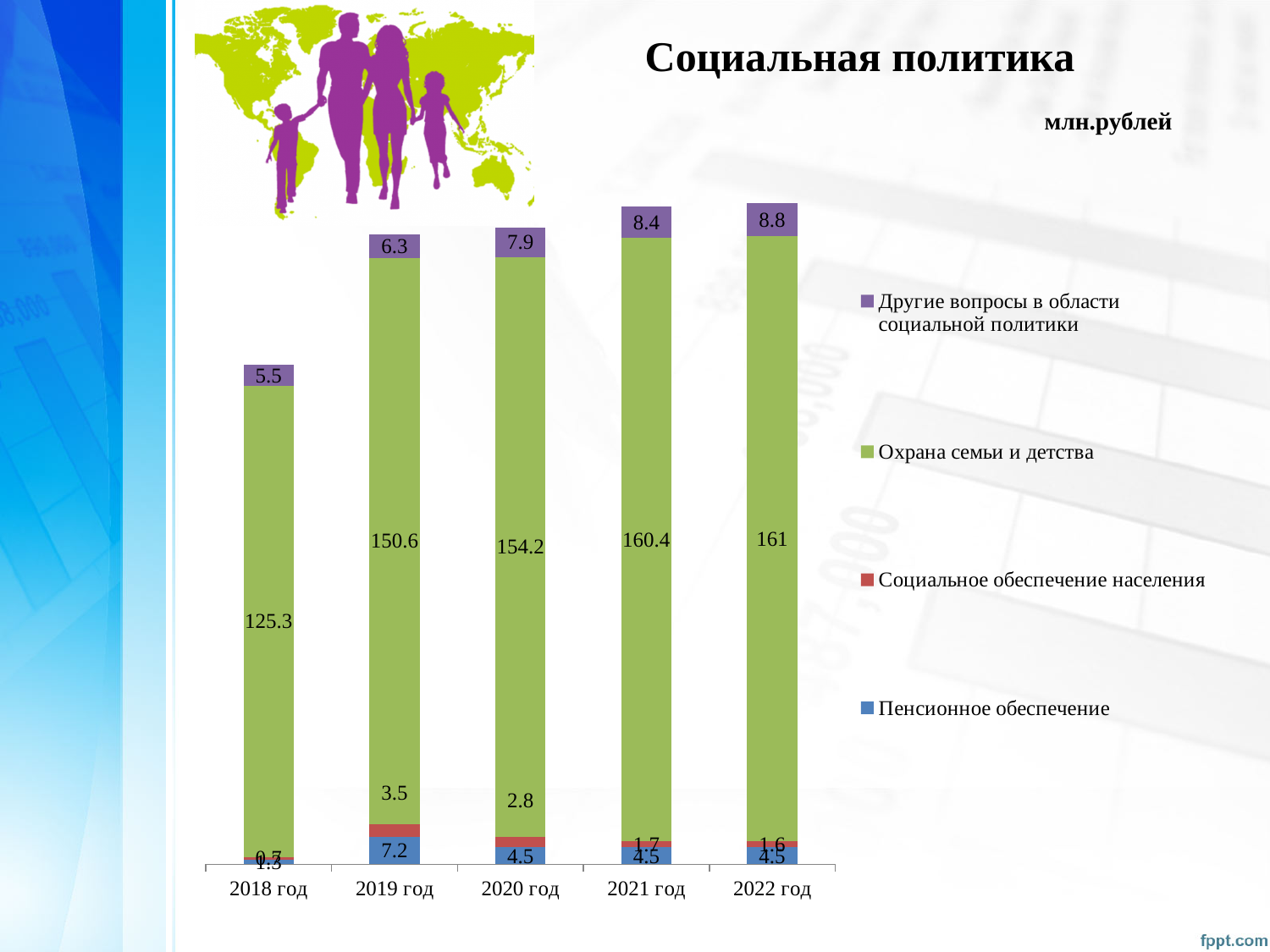
Which year has the larger value for Другие вопросы в области социальной политики, 2019 год or 2020 год? 2020 год What is the value for Охрана семьи и детства in 2020 год? 154.2 What is the value for Другие вопросы в области социальной политики in 2022 год? 8.8 What kind of chart is shown on the slide? stacked bar chart How many years are shown on the x axis of the chart? 5 In which year is the value for Охрана семьи и детства the lowest? 2018 год Do the values for Другие вопросы в области социальной политики rise or fall from 2018 год to 2022 год? rise What is the value for Пенсионное обеспечение in 2019 год? 7.2 What is the difference between the Охрана семьи и детства values for 2019 год and 2018 год? 25.3 In which year is the value for Охрана семьи и детства the highest? 2022 год What is the total of the stacked bar for 2019 год? 167.6 How many series does the legend list? 4